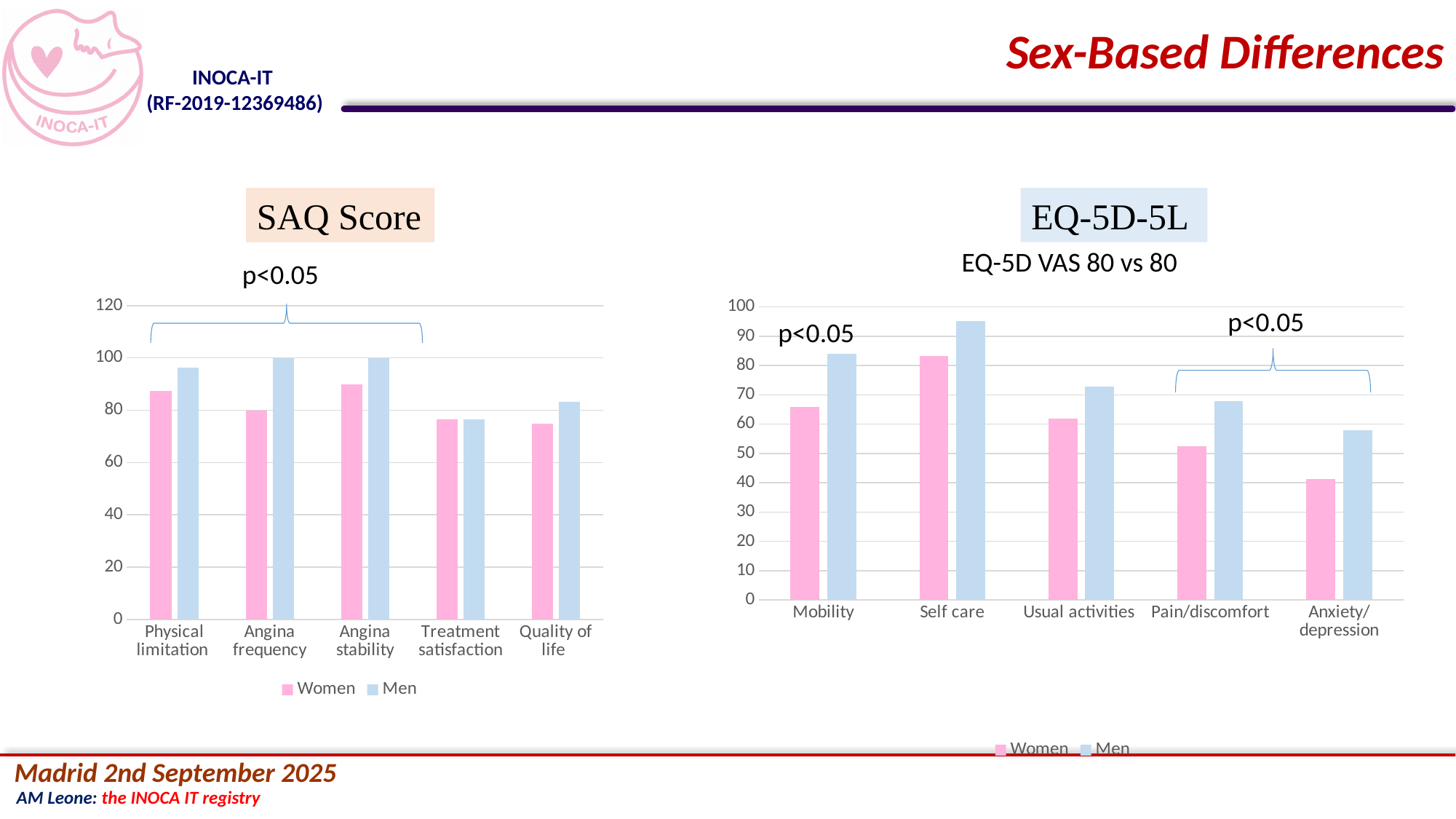
In the SAQ Score chart, is the value for Women in Physical limitation greater or less than 80? greater In the EQ-5D-5L chart, how many categories are shown on the x axis? 5 In the SAQ Score chart, what is the value for Men in Angina frequency? 100 In the SAQ Score chart, which is larger for Physical limitation, Women or Men? Men What kind of chart is the SAQ Score chart? bar chart In the EQ-5D-5L chart, which category has the lowest value for Women? Anxiety/depression What EQ-5D VAS values are stated above the EQ-5D-5L chart? 80 vs 80 In the EQ-5D-5L chart, which category has the highest value for Men? Self care In the EQ-5D-5L chart, is the value for Women in Anxiety/depression greater or less than 50? less In the EQ-5D-5L chart, is the value for Men in Mobility greater or less than 80? greater In the SAQ Score chart, how many series does the legend list? 2 In the SAQ Score chart, how many categories are shown on the x axis? 5